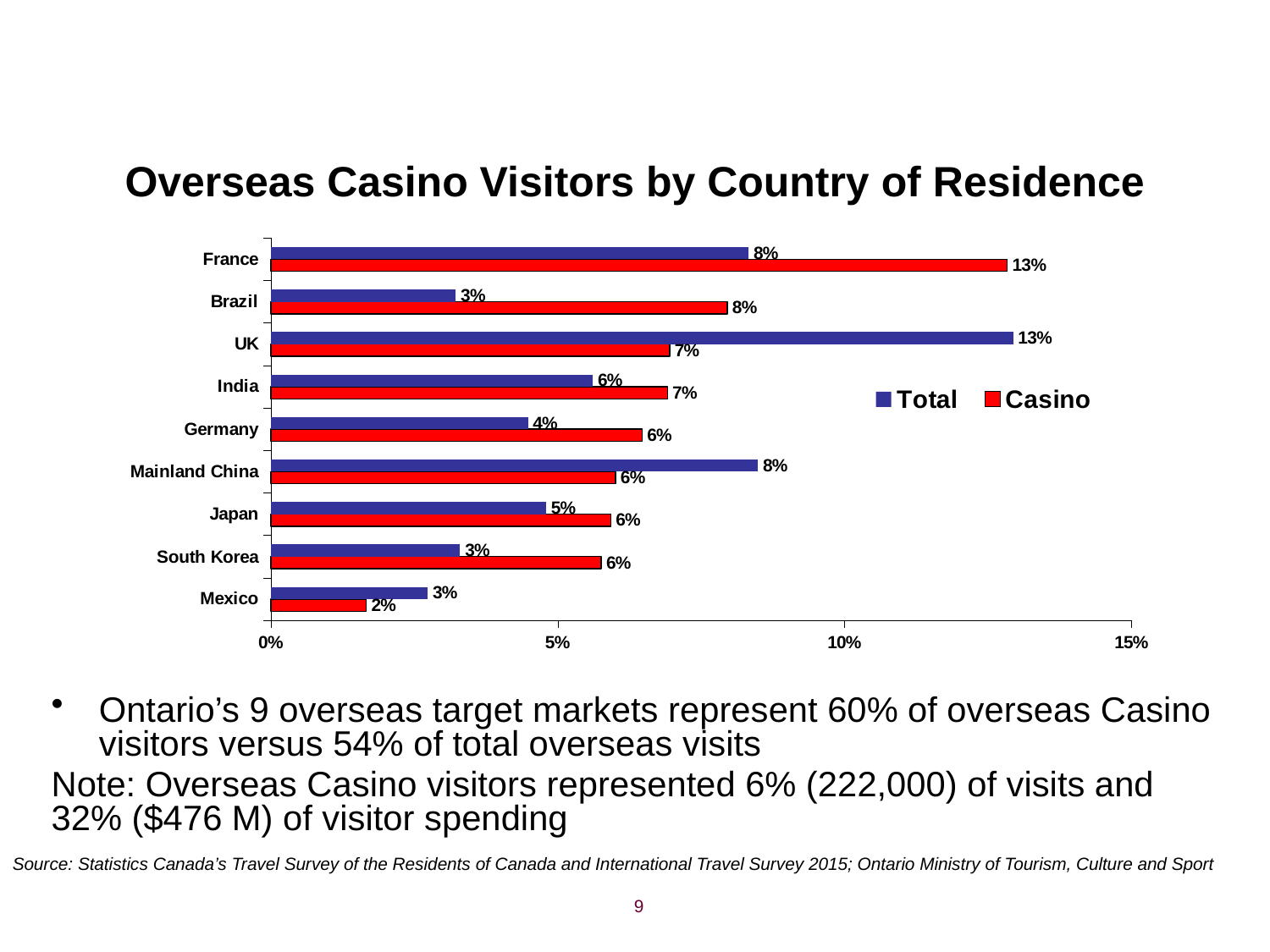
How many countries are shown in the chart? 9 For the UK, which is larger, the Total value or the Casino value? Total Which country has the highest Casino value? France Which country has the lowest Casino value? Mexico How many series does the legend list? 2 Which country has the highest Total value? UK What is the Casino value for South Korea? 6% Is the Casino value for France greater or less than 10%? greater What is the Casino value for France? 13% What is the difference between the Casino and Total values for Brazil? 5 percentage points What is the Total value for the UK? 13% What type of chart is shown on the slide? Bar chart